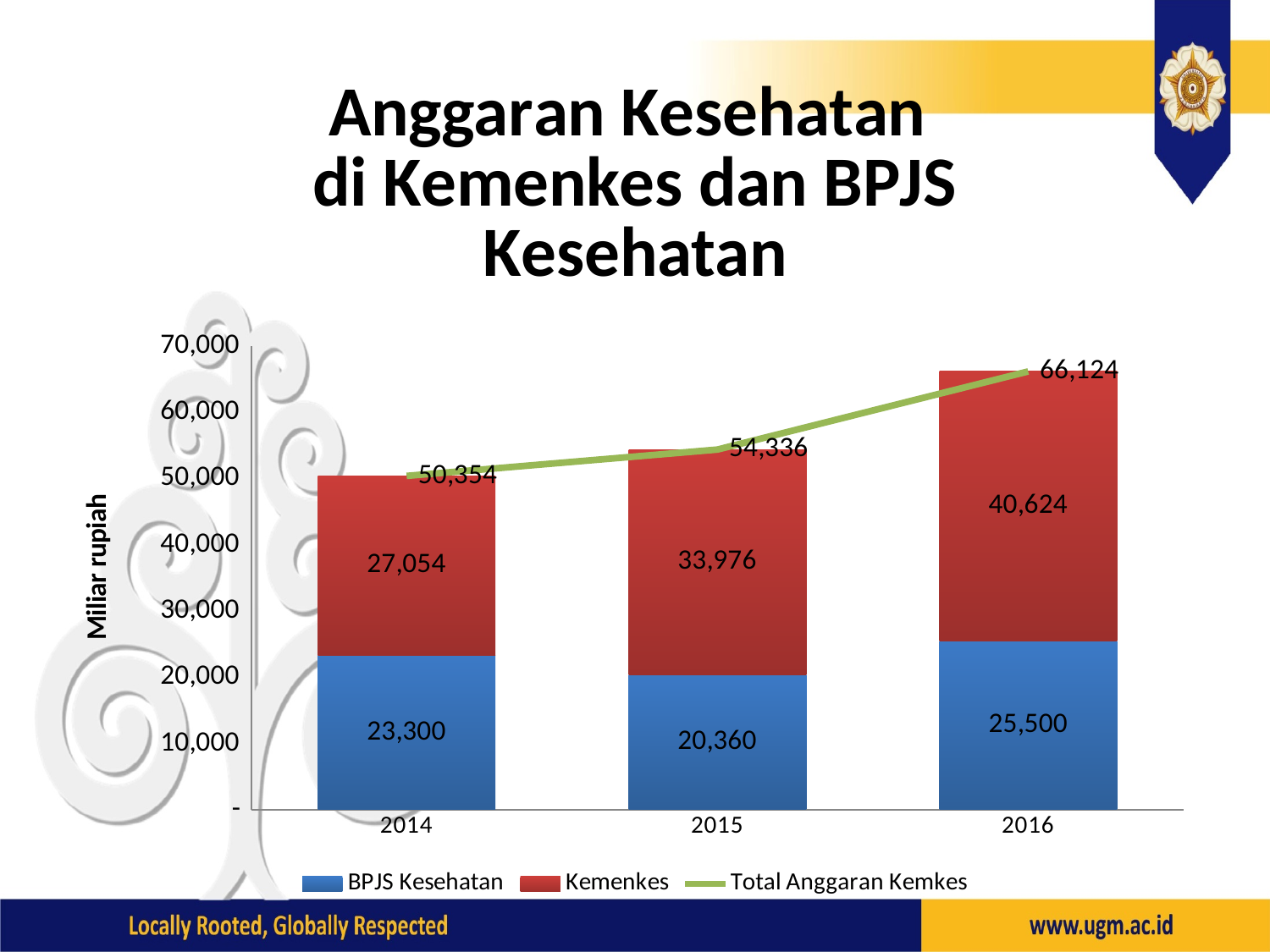
In which year is the BPJS Kesehatan value lowest? 2015 What is the Total Anggaran Kemkes value for 2015? 54,336 What is the value for Kemenkes in 2016? 40,624 Which is larger in 2014: the BPJS Kesehatan value or the Kemenkes value? Kemenkes How many series does the legend list? 3 What is the difference between the Kemenkes values for 2016 and 2015? 6,648 What is the value for BPJS Kesehatan in 2014? 23,300 What is the label on the vertical axis? Miliar rupiah What kind of chart is this? Stacked bar chart with a line In which year is the Kemenkes value highest? 2016 How many years are shown on the x axis? 3 Does the Total Anggaran Kemkes line rise or fall from 2014 to 2016? Rise